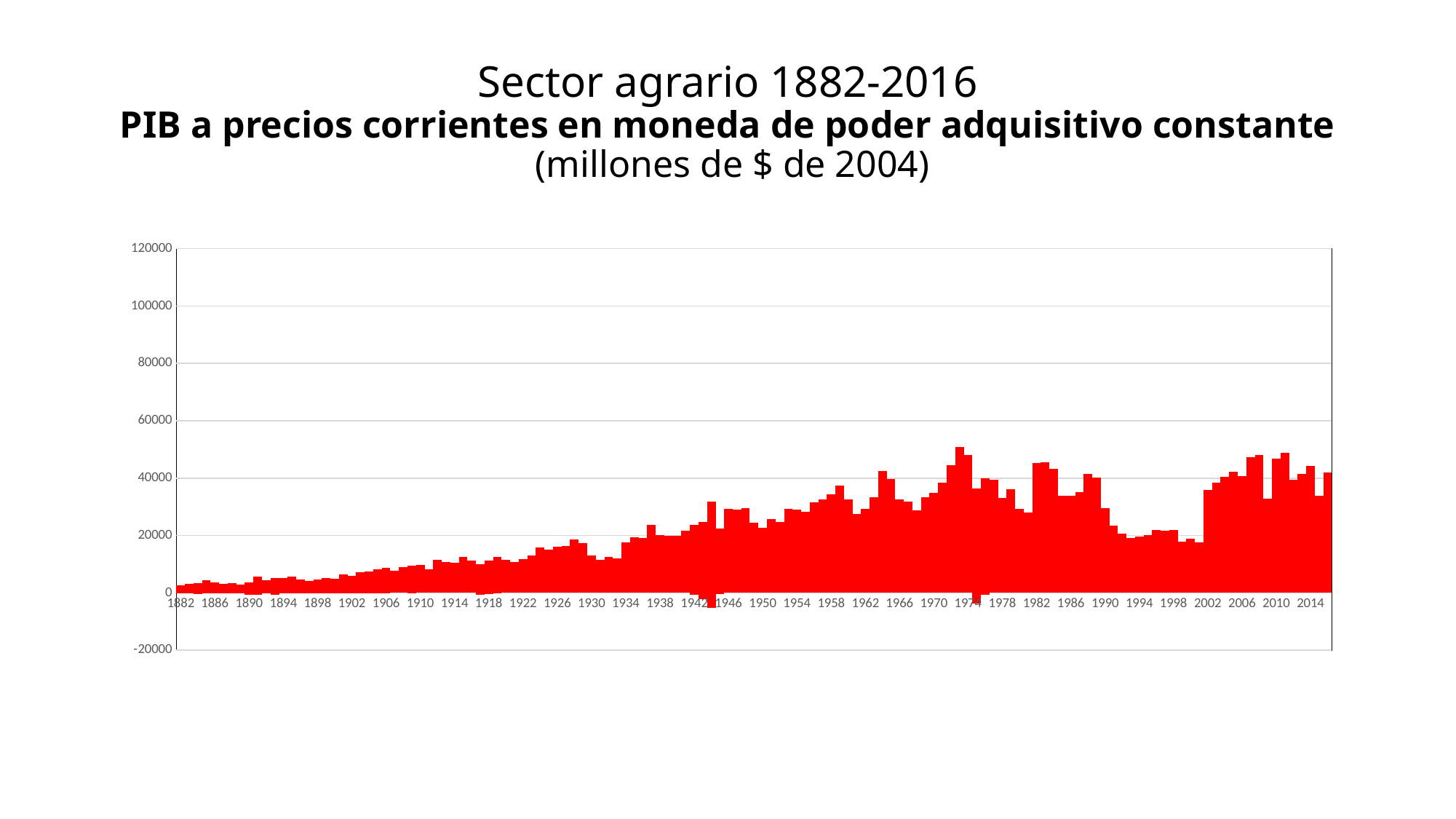
What kind of chart is shown on the slide? bar chart Is the value for 1994 greater or less than 40000? less What is the title of the chart on the slide? Sector agrario 1882-2016 PIB a precios corrientes en moneda de poder adquisitivo constante (millones de $ de 2004) What colour are the bars in the chart? red Is the value for 1930 greater or less than 20000? less Overall, do the values rise or fall from 1882 to 2016? rise Is the value for 1982 greater or less than 40000? greater Which is larger, the value for 1973 or the value for 1994? 1973